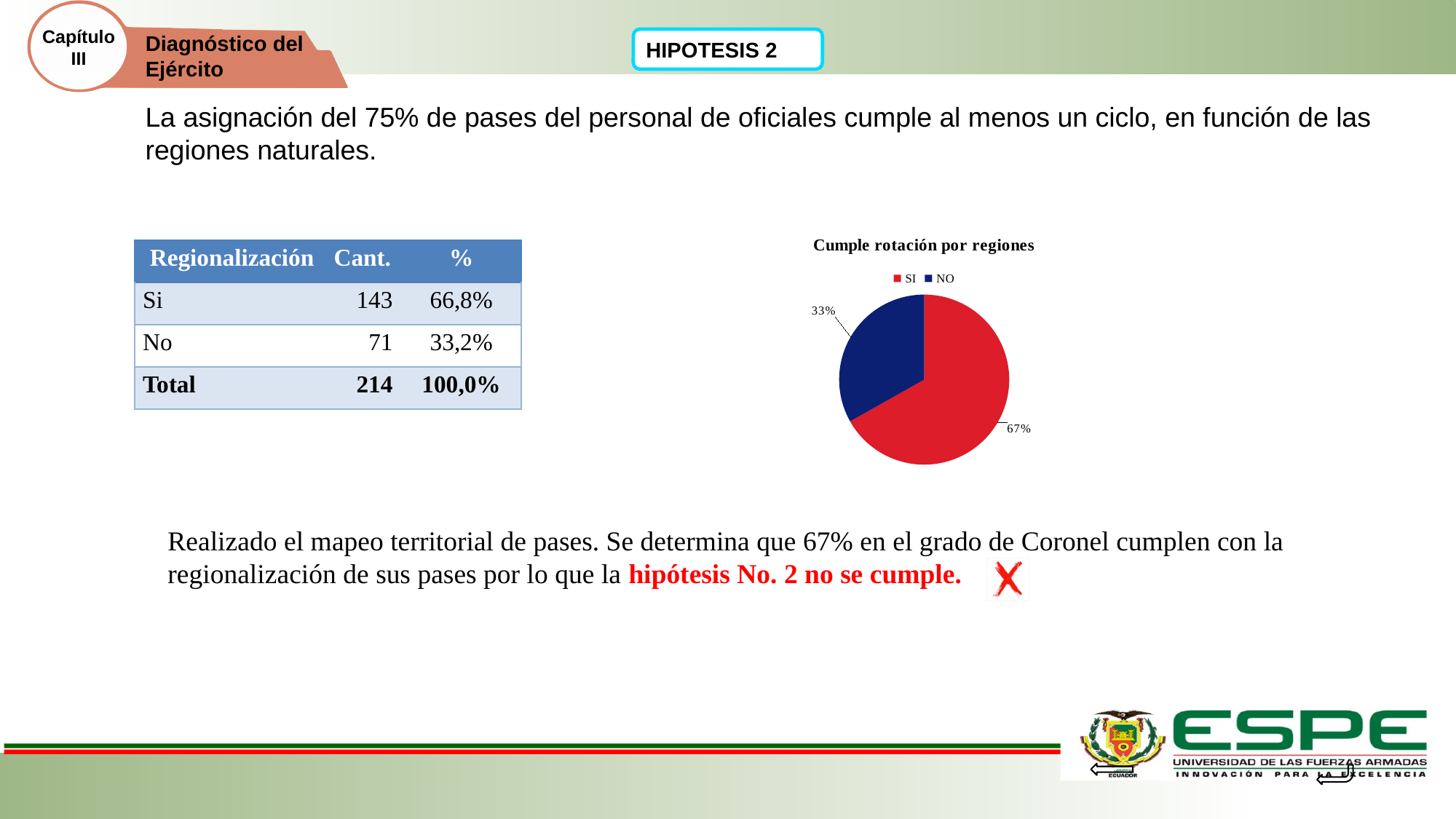
How many slices does the pie chart have? 2 What is the title of the pie chart? Cumple rotación por regiones How many entries does the legend of the pie chart list? 2 Which slice of the pie chart is the smallest? NO What share of the pie does the NO slice represent? 33% What colour is the SI slice in the pie chart? red Which slice of the pie chart is the largest? SI What kind of chart is shown on the slide? pie chart What share of the pie does the SI slice represent? 67% What is the difference in percentage points between the SI and NO slices? 34% Which is larger in the pie chart, SI or NO? SI